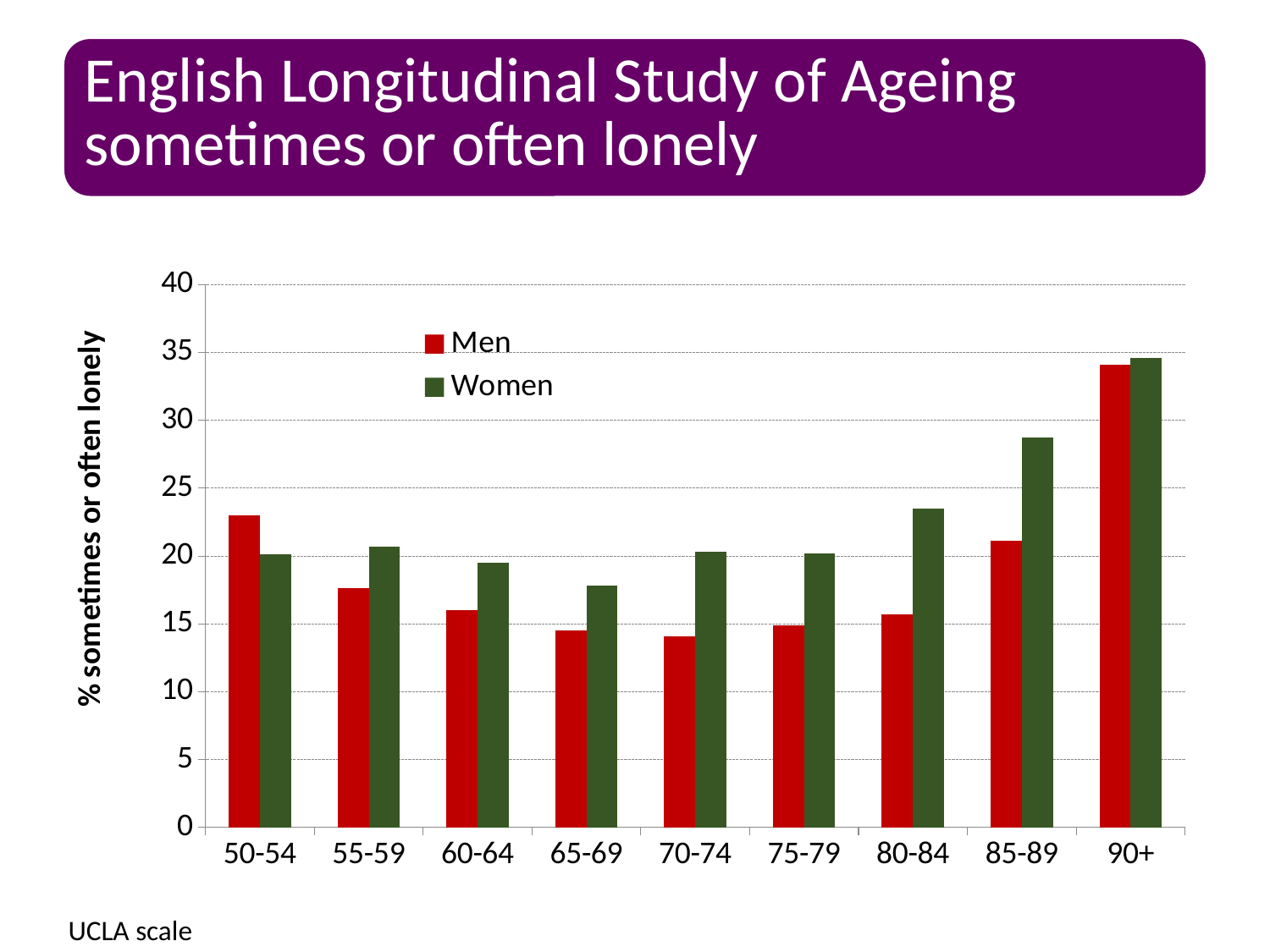
What kind of chart is shown on the slide? bar chart Is the value for Men in the 70-74 age group greater or less than 15? less Is the value for Men in the 50-54 age group greater or less than 20? greater Is the value for Women in the 85-89 age group greater or less than 25? greater How many series does the legend list? 2 In the 85-89 age group, which is larger, the value for Men or for Women? Women Which age group has the lowest value for Women? 65-69 Which age group has the highest value for Men? 90+ How many age groups are shown on the x axis? 9 What is the label on the y axis? % sometimes or often lonely Which age group has the highest value for Women? 90+ In the 50-54 age group, which is larger, the value for Men or for Women? Men